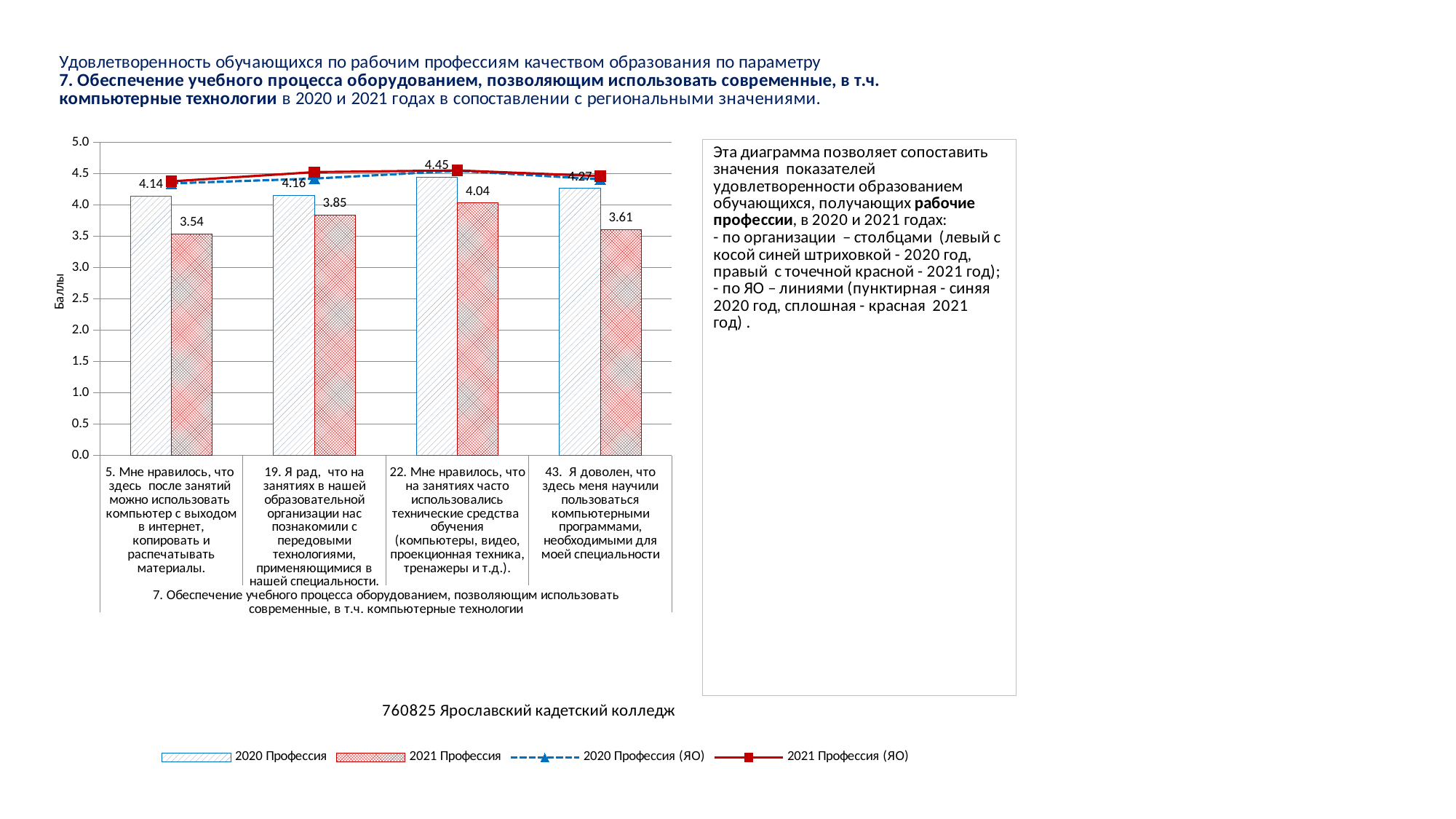
What kind of chart is shown on the slide? Combined bar and line chart Which statement has the highest 2020 Профессия bar? 22. Мне нравилось, что на занятиях часто использовались технические средства обучения What is the value of the 2020 Профессия bar for statement 5 ("Мне нравилось, что здесь после занятий можно использовать компьютер...")? 4.14 Is the 2021 Профессия (ЯО) line value for statement 5 greater or less than 4.0? greater What is the value of the 2021 Профессия bar for statement 19 ("Я рад, что на занятиях в нашей образовательной организации нас познакомили с передовыми технологиями...")? 3.85 What is the value of the 2021 Профессия bar for statement 43 ("Я доволен, что здесь меня научили пользоваться компьютерными программами...")? 3.61 How many statements (categories) are shown on the x axis? 4 How many series does the legend list? 4 Which statement has the lowest 2021 Профессия bar? 5. Мне нравилось, что здесь после занятий можно использовать компьютер с выходом в интернет What is the difference between the 2020 Профессия and 2021 Профессия bars for statement 43? 0.66 What is the label of the y axis? Баллы For statement 22, which bar is larger: 2020 Профессия or 2021 Профессия? 2020 Профессия